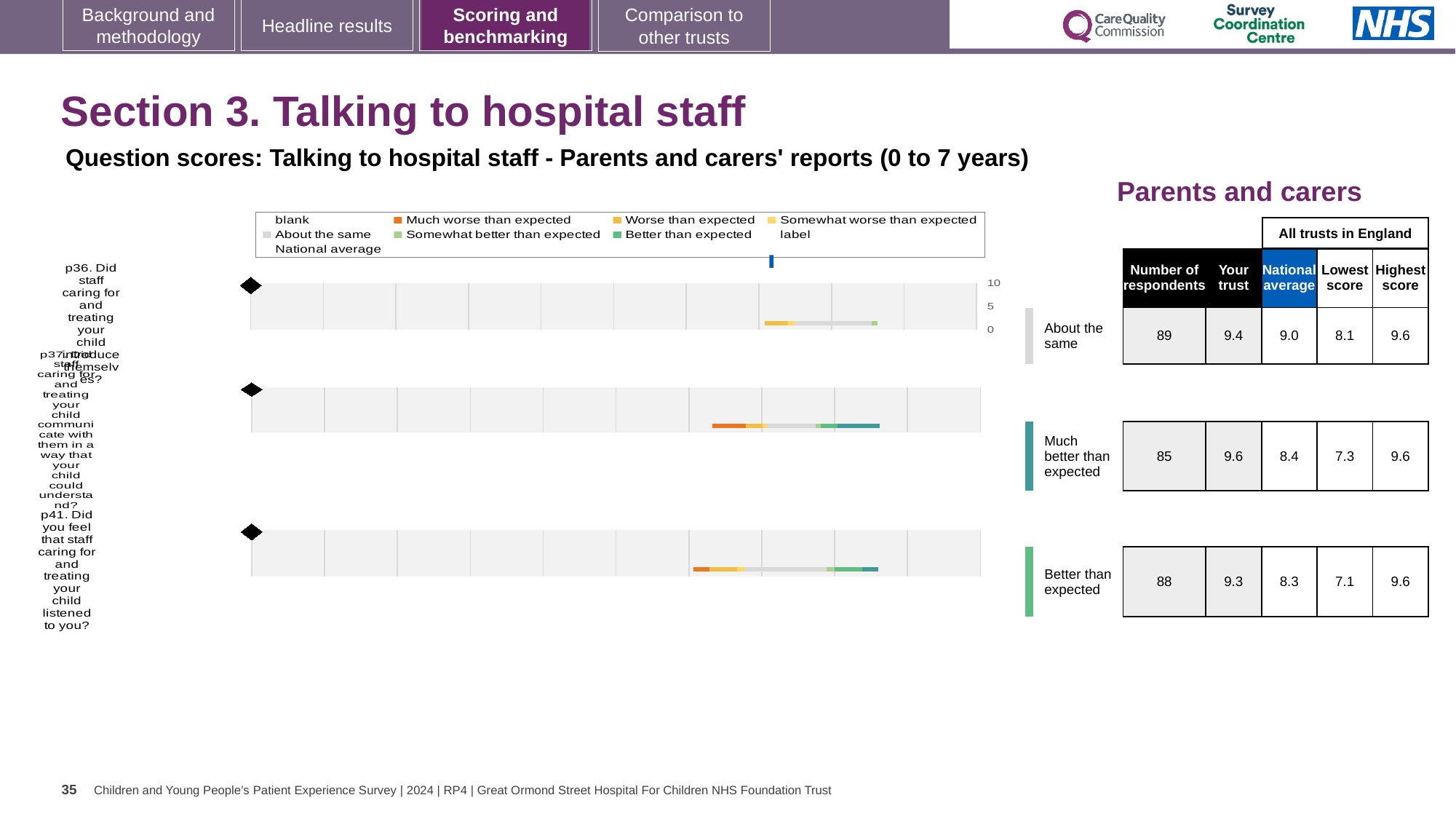
What kind of chart is shown on the slide? bar chart Which question has the lowest 'Your trust' score? p41 What is the difference between the 'Your trust' score and the national average for p37? 1.2 What is the 'Your trust' score for p37 (Did staff communicate with them in a way that your child could understand)? 9.6 What is the lowest score among all trusts in England for p41? 7.1 For p36, which is larger: the 'Your trust' score or the national average? Your trust Which question has the highest 'Your trust' score? p37 How many respondents answered p37? 85 What is the national average score for p41 (Did you feel that staff caring for and treating your child listened to you)? 8.3 What benchmark category is shown for p36? About the same How many survey questions (categories) are plotted in the chart? 3 What is the 'Your trust' score for p36 (Did staff caring for and treating your child introduce themselves)? 9.4